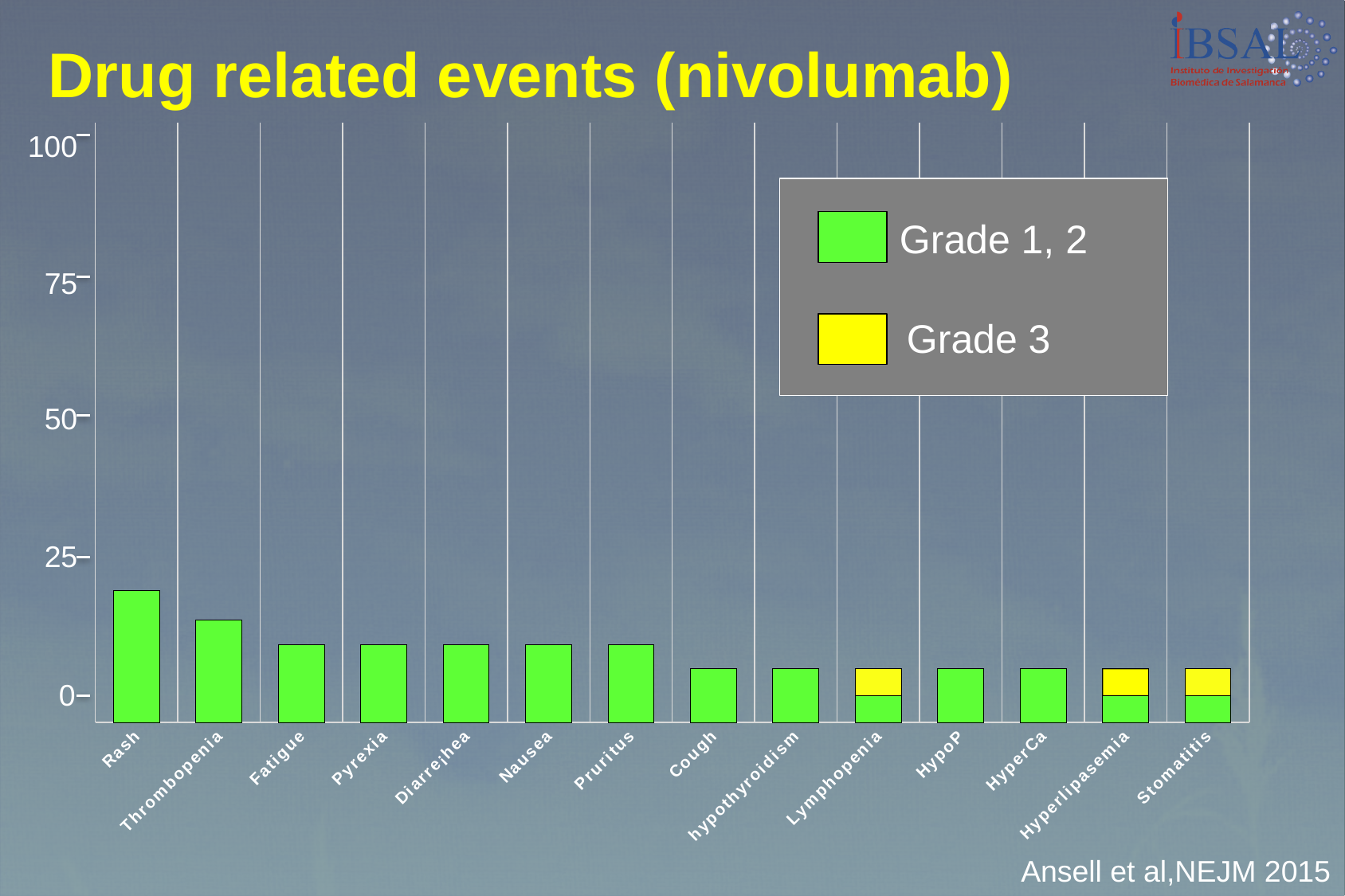
Is the value for Rash greater or less than 25? less Which is larger, the bar for Thrombopenia or the bar for Nausea? Thrombopenia What kind of chart is shown on the slide? bar chart Do the bar heights generally rise or fall from left to right along the x axis? fall How many series does the legend list? 2 Is the value for Thrombopenia greater or less than 25? less How many categories (adverse events) are shown on the x axis? 14 Which adverse event has the highest bar? Rash Which is larger, the bar for Fatigue or the bar for Cough? Fatigue Which colour represents Grade 3 events in the legend? yellow Which is larger, the bar for Rash or the bar for Thrombopenia? Rash What is the title of the chart? Drug related events (nivolumab)